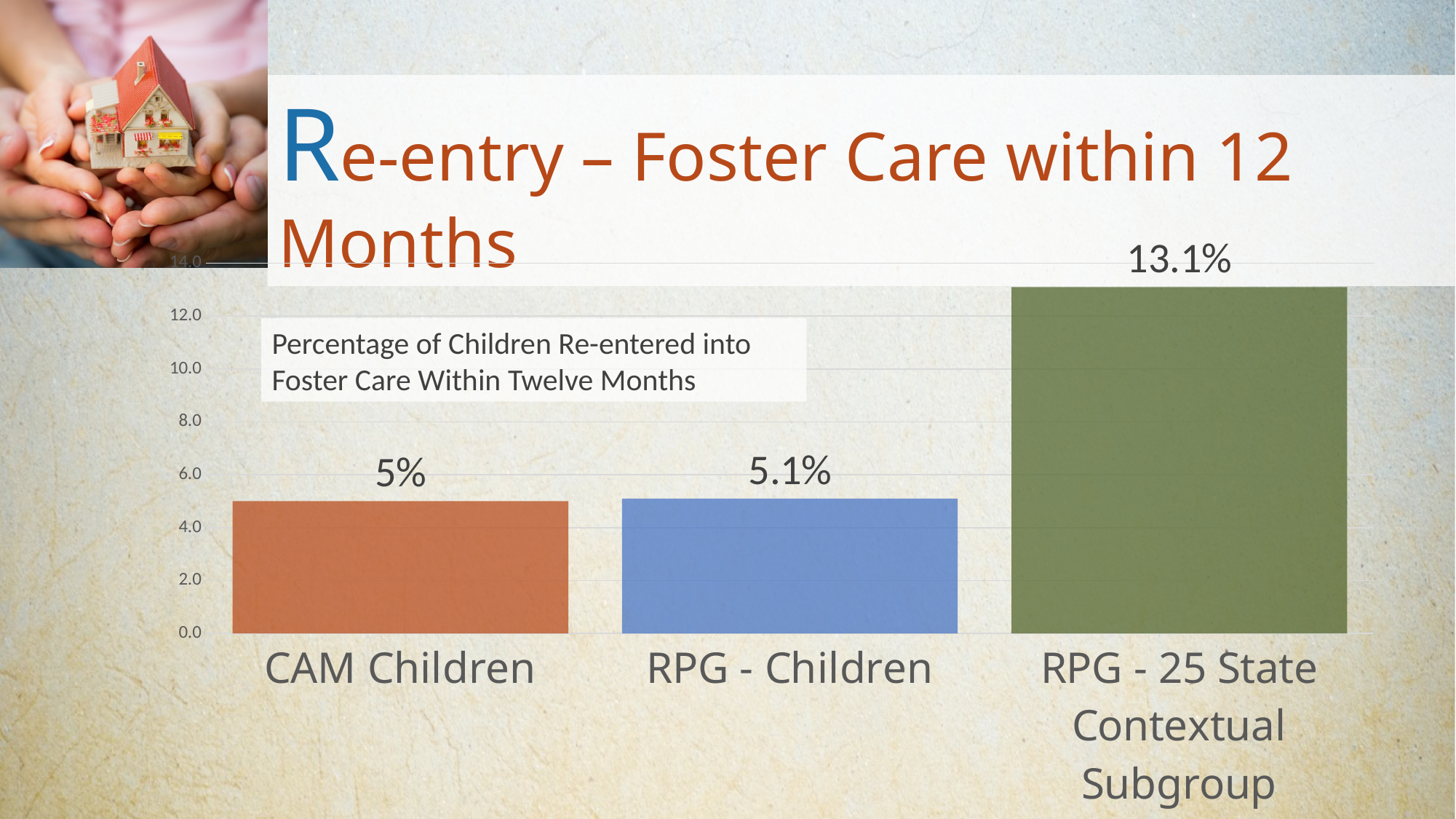
What is the value for RPG - 25 State Contextual Subgroup? 13.1% What is the difference between the values for RPG - 25 State Contextual Subgroup and CAM Children? 8.1% What is the difference between the values for RPG - 25 State Contextual Subgroup and RPG - Children? 8% Which category has the highest value? RPG - 25 State Contextual Subgroup Is the value for RPG - 25 State Contextual Subgroup greater or less than 12.0? greater Is the value for CAM Children greater or less than 6.0? less What is the value for CAM Children? 5% What kind of chart is shown on the slide? bar chart What is the title of the chart? Percentage of Children Re-entered into Foster Care Within Twelve Months Which is larger, the value for RPG - 25 State Contextual Subgroup or the value for CAM Children? RPG - 25 State Contextual Subgroup What is the value for RPG - Children? 5.1% How many categories are shown in the chart? 3